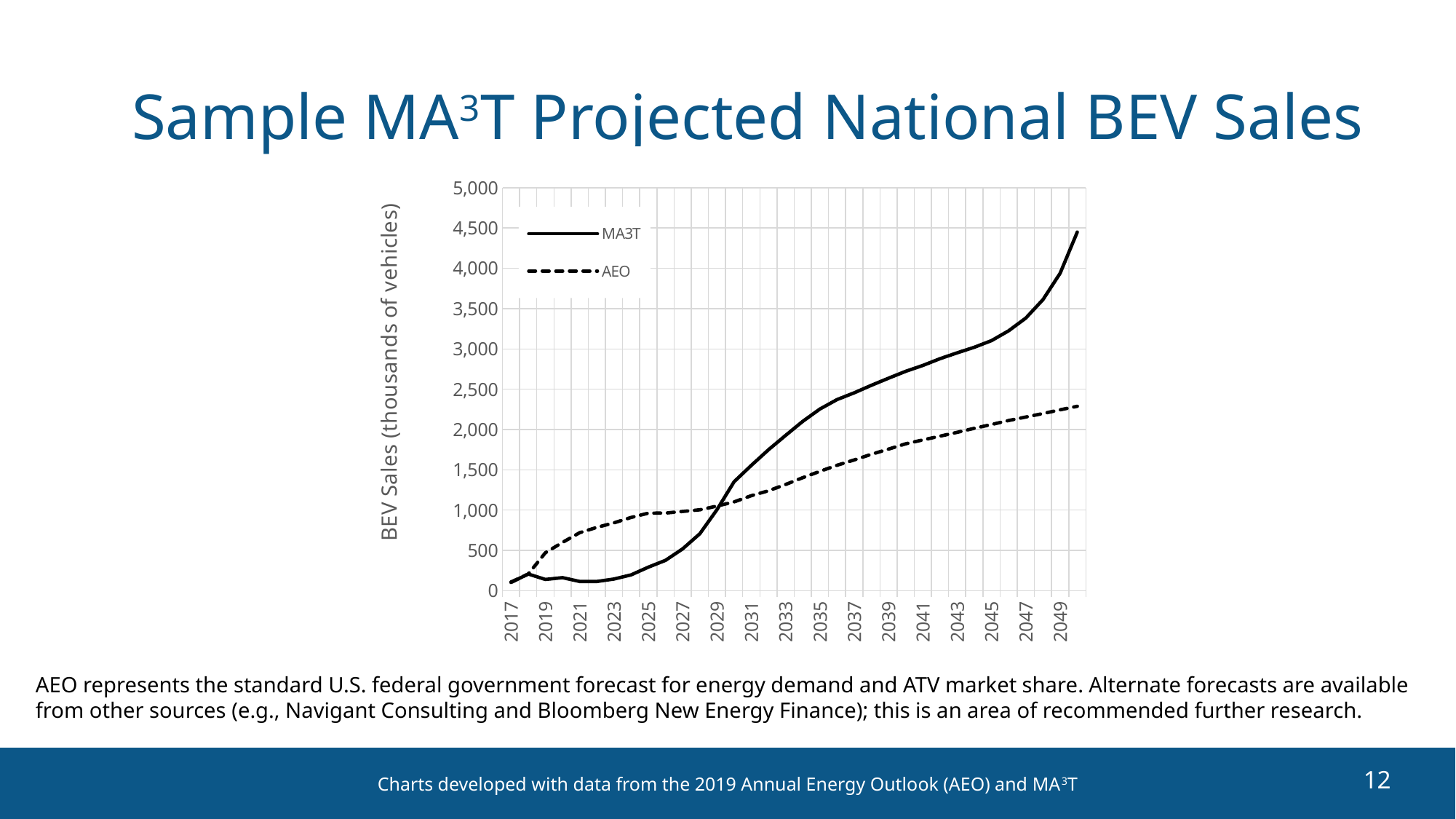
What are the two series named in the legend? MA3T and AEO In 2045, which series has the higher value, MA3T or AEO? MA3T What kind of chart is shown on the slide? line chart Is the AEO value for 2045 greater or less than 2,500? less How many series does the chart's legend list? 2 Is the MA3T value for 2021 greater or less than 500? less In 2025, which series has the higher value, MA3T or AEO? AEO What is the label on the vertical axis of the chart? BEV Sales (thousands of vehicles) Is the MA3T value for 2045 greater or less than 2,500? greater Does the MA3T series rise or fall overall from 2017 to the end of the projection? rise